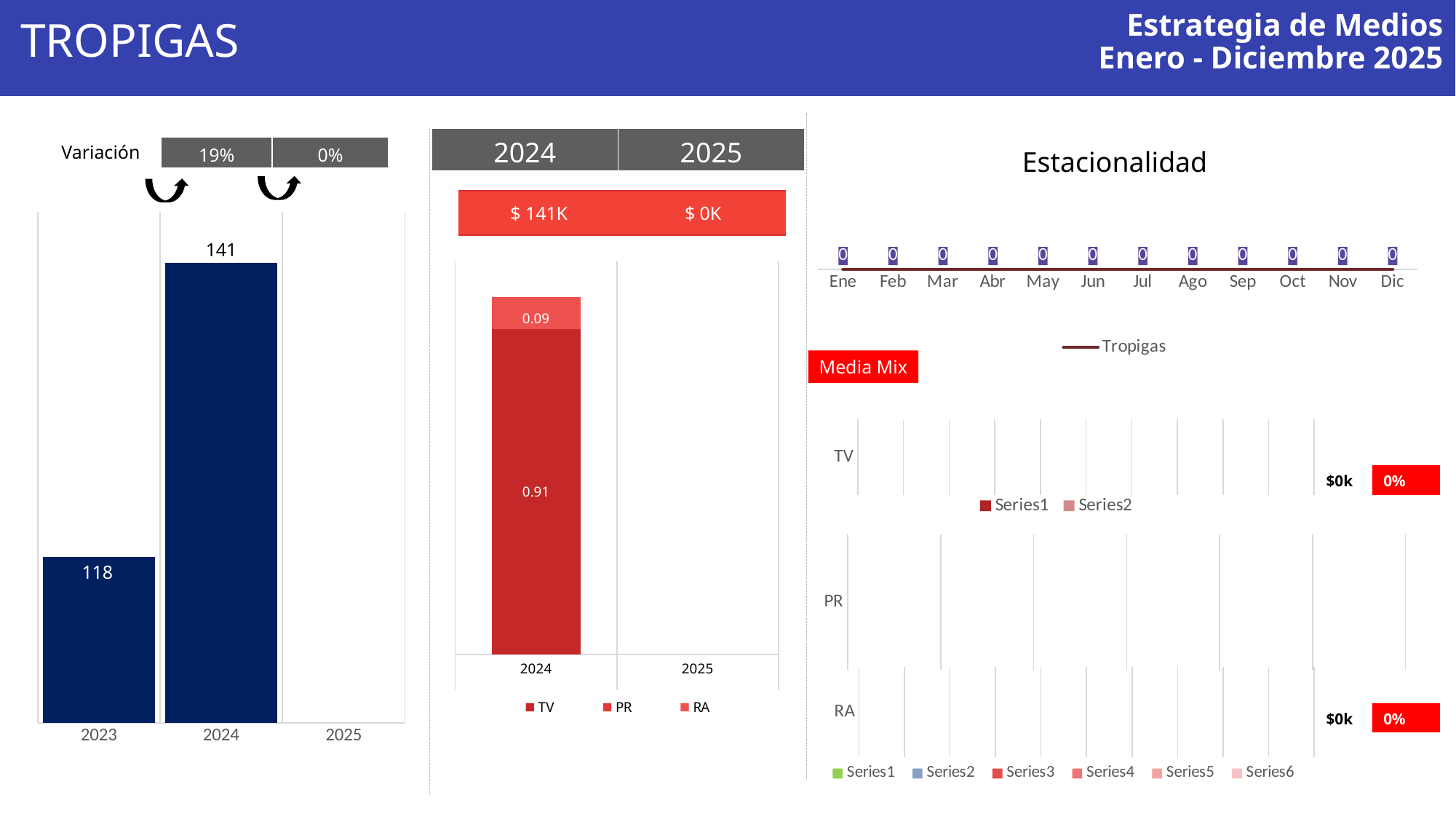
In the left bar chart, what is the value for 2023? 118 In the middle stacked bar chart, what is the value of the smaller top segment of the 2024 bar? 0.09 In the left bar chart, what is the value for 2024? 141 In the left bar chart, what is the difference between the 2024 and 2023 values? 23 In the Estacionalidad chart, how many months are shown on the x axis? 12 What kind of chart is the left chart showing 2023, 2024 and 2025? bar chart How many series does the legend of the middle stacked bar chart (2024/2025) list? 3 In the middle stacked bar chart, what is the value of the TV segment for 2024? 0.91 In the left bar chart, which is larger, the value for 2023 or for 2024? 2024 How many year categories are on the x axis of the left bar chart? 3 In the Estacionalidad chart, what series name does the legend show? Tropigas In the left bar chart, which year has the highest value? 2024